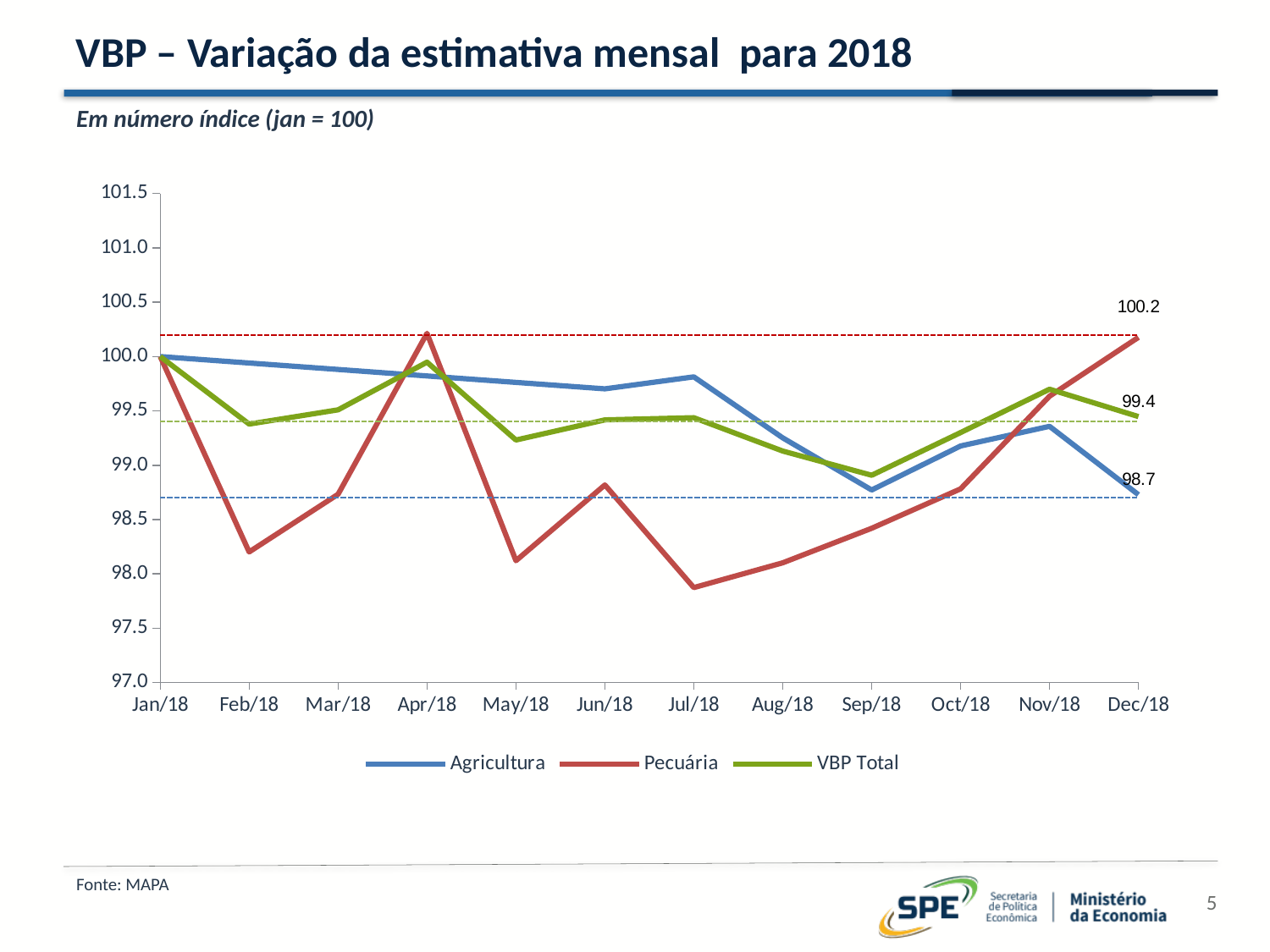
What kind of chart is shown on the slide? line chart How many months are plotted along the x axis? 12 Is the value for Pecuária in Jul/18 greater or less than 98.5? less What is the value of Agricultura in Dec/18? 98.7 What is the value of VBP Total in Dec/18? 99.4 Which series has the highest value in Dec/18? Pecuária In which month does Pecuária reach its lowest value? Jul/18 Does the Pecuária line rise or fall from Sep/18 to Dec/18? rise What is the difference between the Pecuária and Agricultura values in Dec/18? 1.5 What is the difference between the Pecuária and VBP Total values in Dec/18? 0.8 How many series does the legend list? 3 What is the value of Pecuária in Dec/18? 100.2